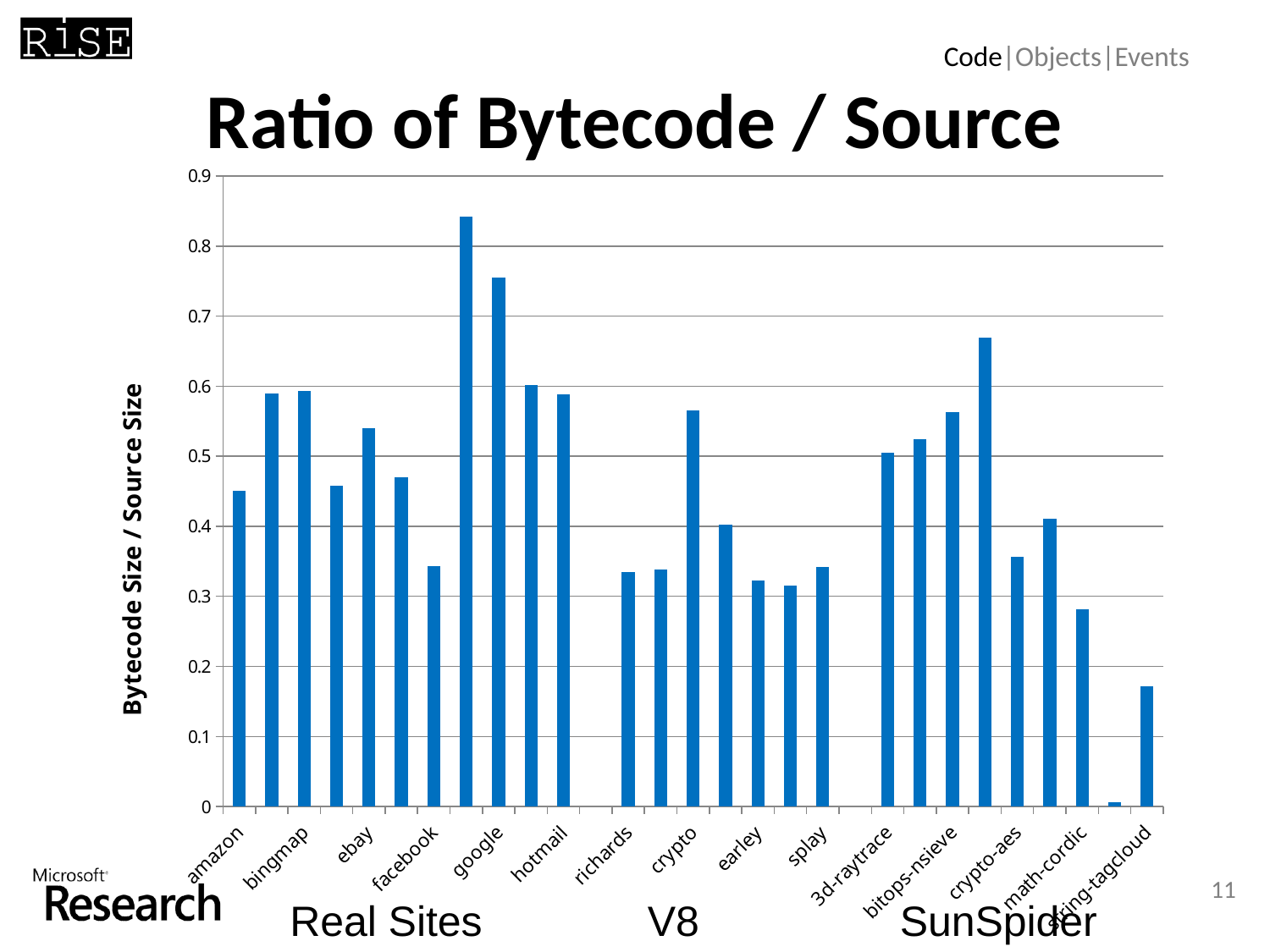
Is the value for string-tagcloud greater or less than 0.2? less Which has the larger value, crypto or richards? crypto Is the value for crypto greater or less than 0.5? greater What is the label on the vertical axis of the chart? Bytecode Size / Source Size Is the value for facebook greater or less than 0.4? less What kind of chart is shown on the slide? bar chart What is the title of the chart? Ratio of Bytecode / Source Which has the larger value, google or hotmail? google Which has the larger value, bitops-nsieve or crypto-aes? bitops-nsieve